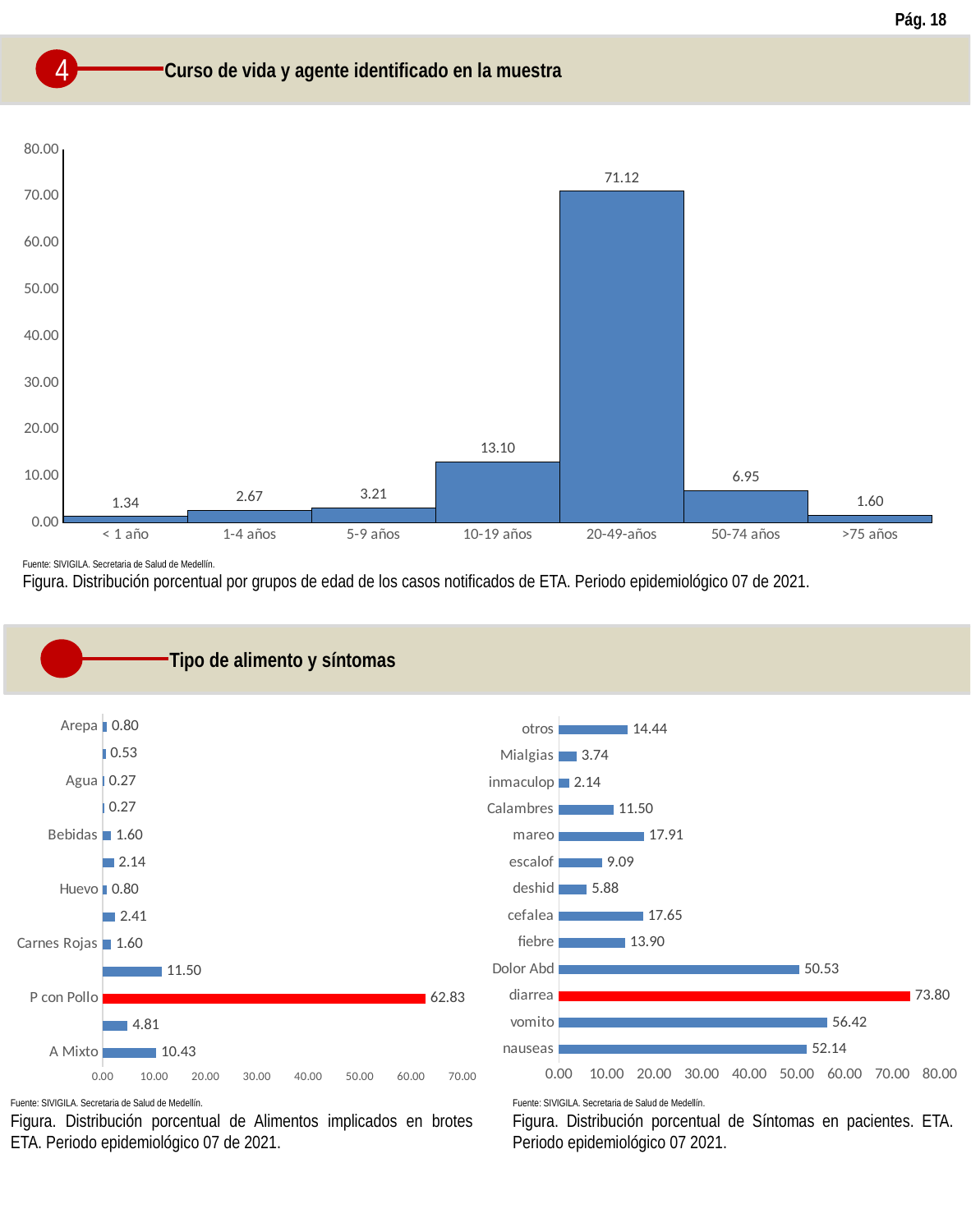
In the top chart (age groups), what is the difference between the values for 10-19 años and 50-74 años? 6.15 In the bottom-right chart (Síntomas), what is the value for vomito? 56.42 In the bottom-right chart (Síntomas), which symptom has the highest value? diarrea In the top chart (age groups), what is the value for 20-49-años? 71.12 In the bottom-right chart (Síntomas), how many symptom categories are listed? 13 In the bottom-left chart (Alimentos), what is the value for P con Pollo? 62.83 In the bottom-left chart (Alimentos), what colour is the bar for P con Pollo? Red In the bottom-right chart (Síntomas), what is the difference between the values for diarrea and Dolor Abd? 23.27 In the top chart (age groups), which age group has the lowest value? < 1 año What type of chart is the top chart showing the distribution by age group? Bar chart In the top chart (age groups), how many age groups are shown on the x axis? 7 In the bottom-left chart (Alimentos), which of Bebidas or A Mixto has the larger value? A Mixto